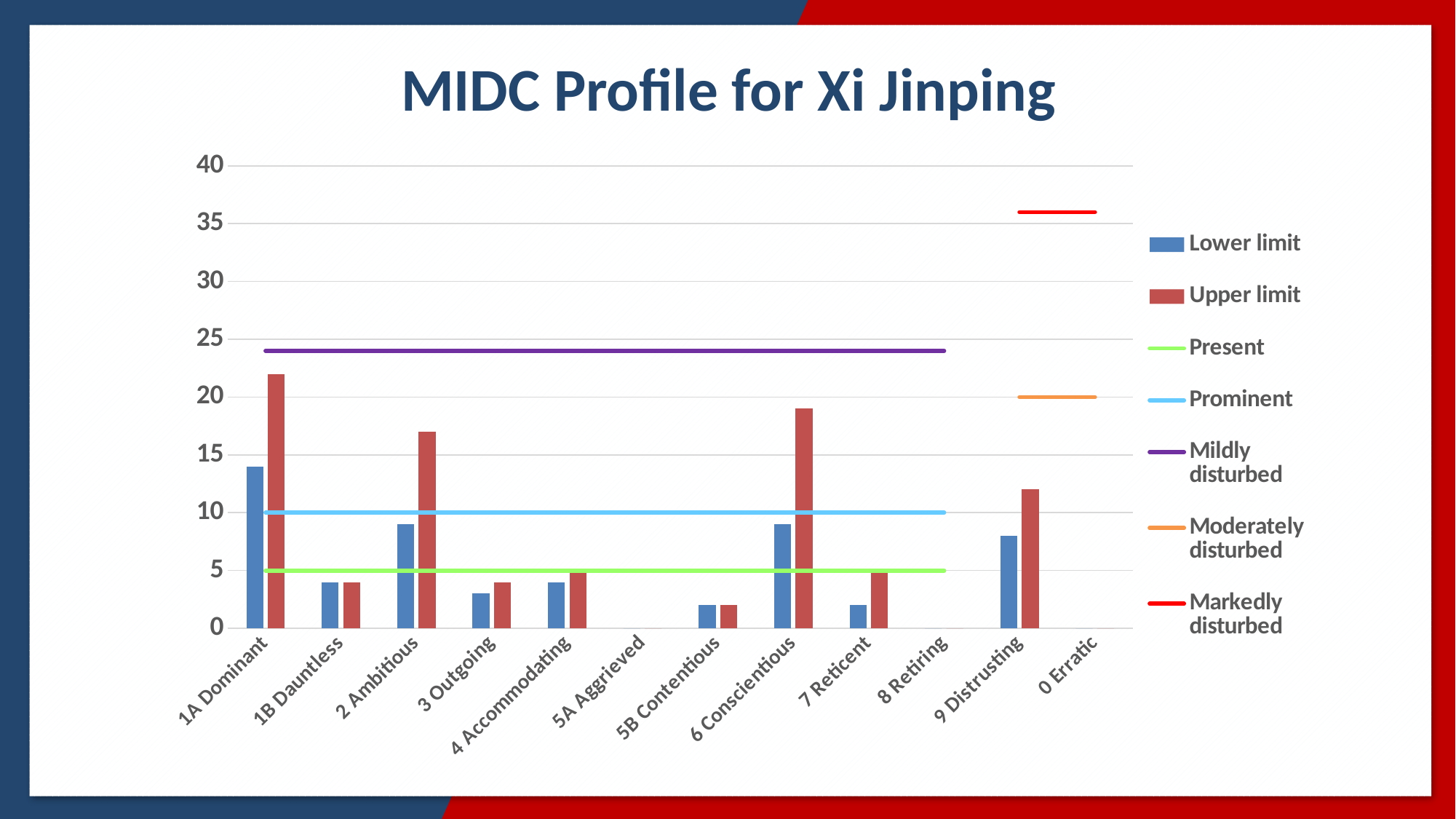
How many series does the legend list? 7 What is the title of the chart? MIDC Profile for Xi Jinping Which category has the highest Upper limit bar? 1A Dominant Which is larger, the Lower limit for 1A Dominant or the Lower limit for 2 Ambitious? 1A Dominant At what value is the Moderately disturbed marker drawn? 20 How many categories are shown on the x axis? 12 Which category has the highest Lower limit bar? 1A Dominant Is the Upper limit value for 1A Dominant greater or less than 20? greater At what value is the Prominent line drawn? 10 What kind of chart is used to show the Lower limit and Upper limit series? Bar chart At what value is the Present line drawn? 5 Is the Lower limit value for 9 Distrusting greater or less than 10? less